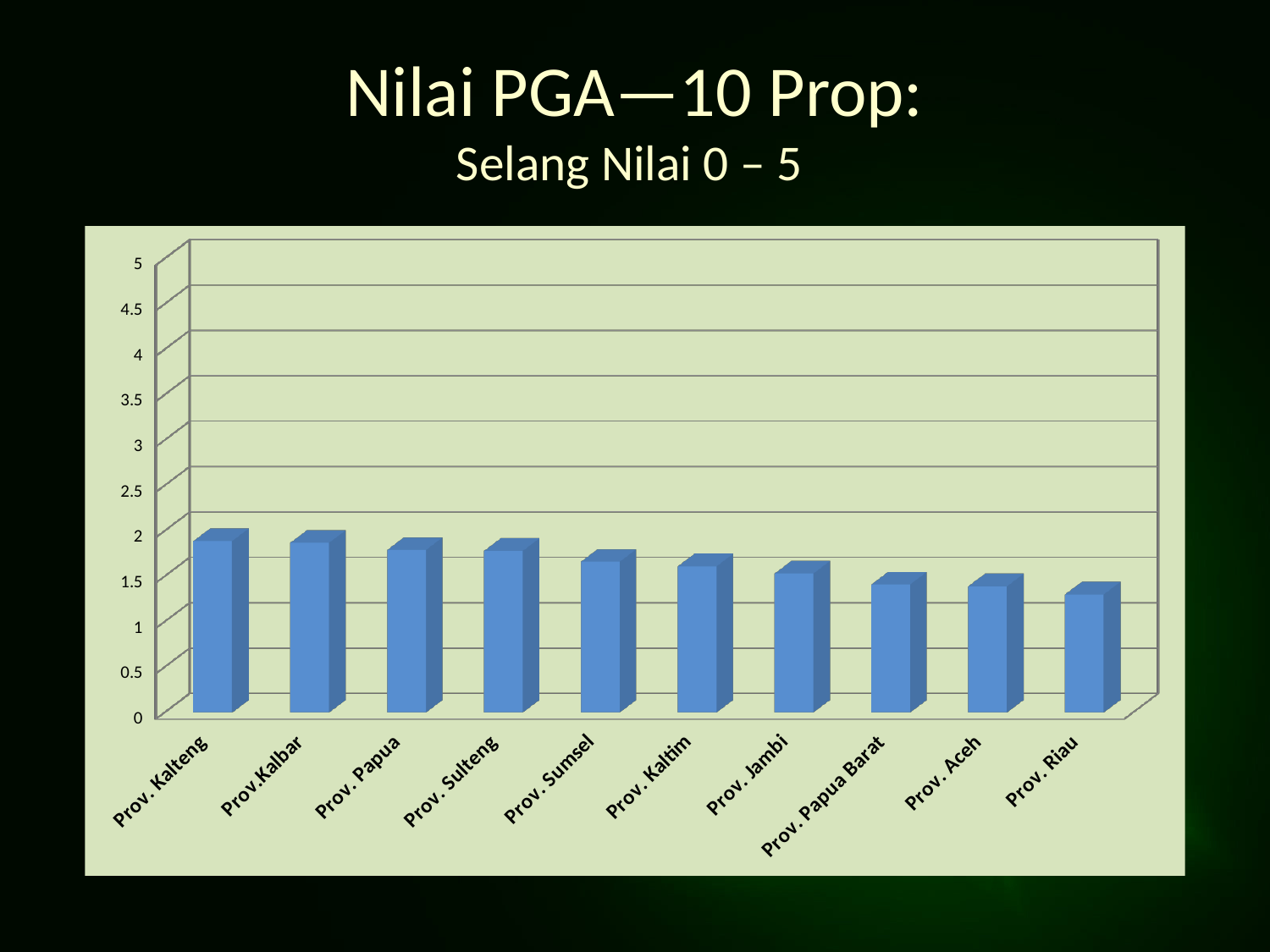
Which has a larger value, Prov. Kalteng or Prov. Riau? Prov. Kalteng How many provinces are plotted on the chart? 10 Is the value for Prov. Aceh greater or less than 1? greater Which province has the highest value on the chart? Prov. Kalteng Which province has the lowest value on the chart? Prov. Riau Which has a larger value, Prov. Papua or Prov. Jambi? Prov. Papua What kind of chart is shown on the slide? Bar chart Is the value for Prov. Kalteng greater or less than 1.5? greater What is the maximum value shown on the vertical axis? 5 Is the value for Prov. Kalteng greater or less than 2? less Do the values rise or fall moving from left to right along the x axis? Fall